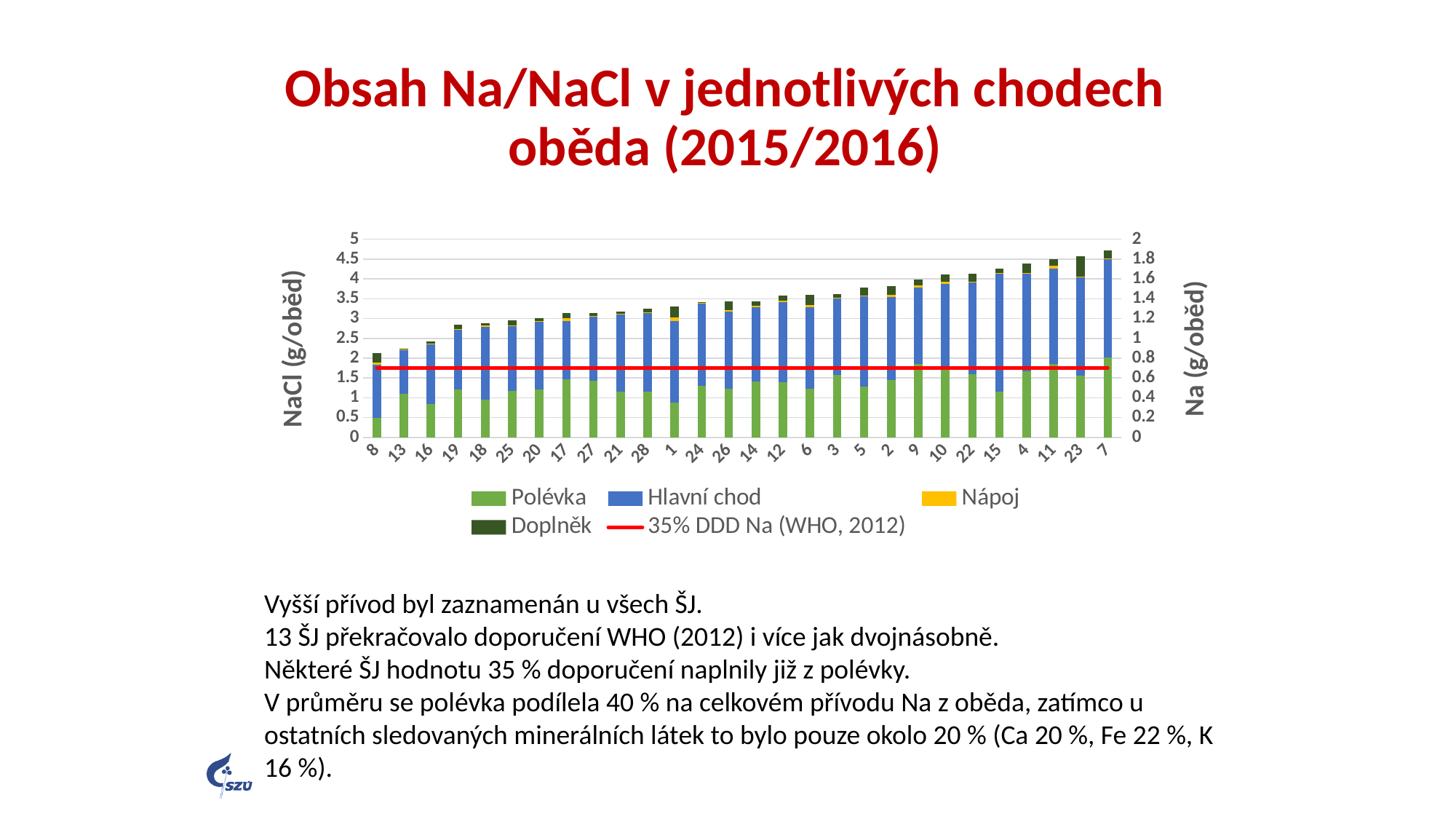
What kind of chart is shown on the slide? Stacked bar chart Which category has the highest total bar? 7 What is the title of the left vertical axis? NaCl (g/oběd) How many entries does the legend list? 5 Do the total bar values rise or fall from left to right along the x axis? Rise Which has the larger total bar, category 16 or category 9? 9 Is the total value for category 8 greater or less than 2.5 on the left axis? less How many categories (bars) are plotted along the x axis? 28 Is the total value for category 1 greater or less than 3 on the left axis? greater Is the total value for category 7 greater or less than 4 on the left axis? greater What does the red horizontal line represent according to the legend? 35% DDD Na (WHO, 2012) Which category has the lowest total bar? 8